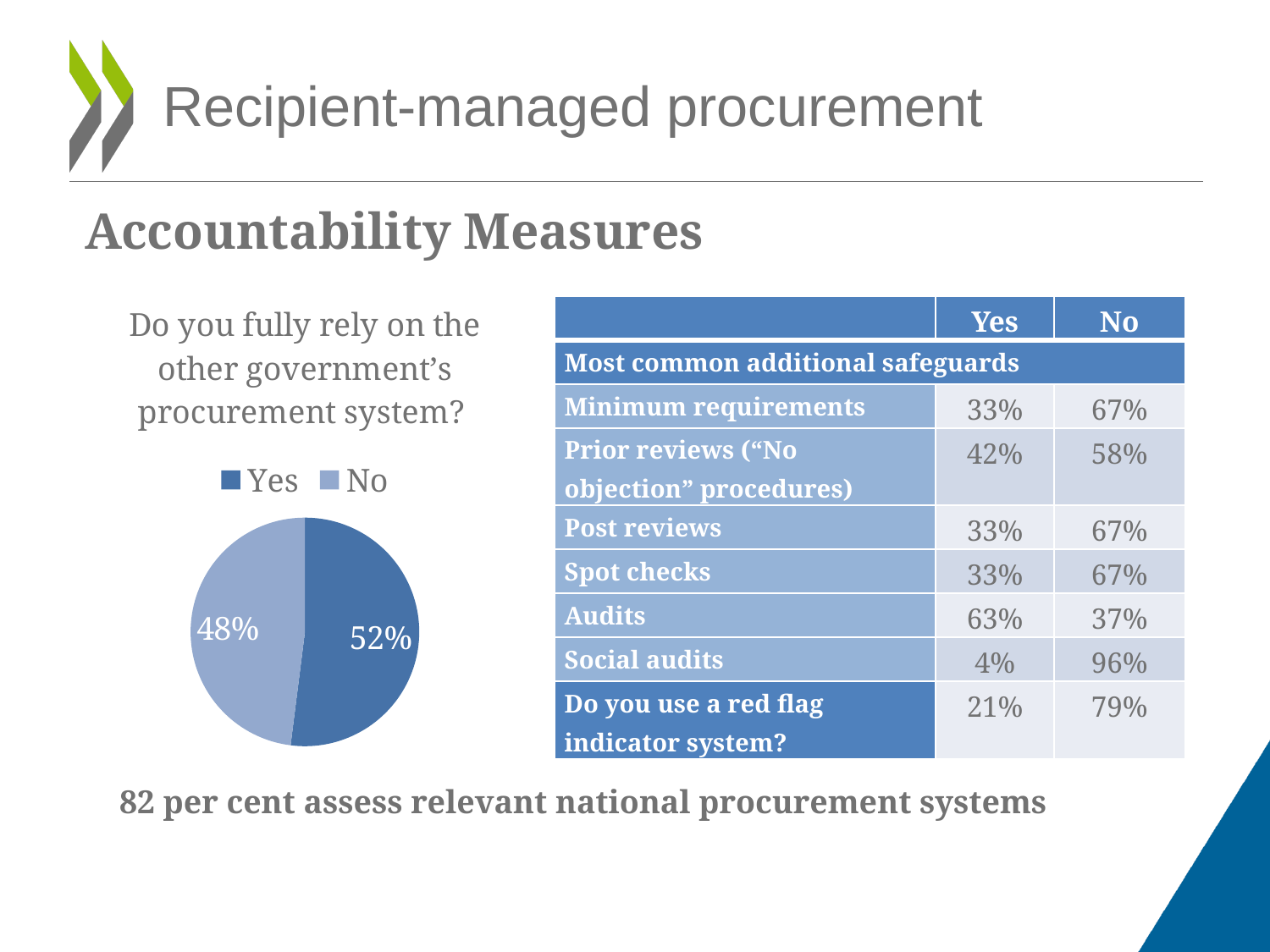
What kind of chart is shown on the slide? Pie chart Which slice of the pie chart is the largest? Yes Which slice of the pie chart is the smallest? No In the pie chart, which is larger, the "Yes" slice or the "No" slice? Yes How many slices does the pie chart have? 2 How many entries does the pie chart's legend list? 2 What share of the pie does the "No" slice represent? 48% What is the difference in percentage points between the "Yes" and "No" slices of the pie chart? 4 Which legend entry of the pie chart is shown in the darker blue colour? Yes What percentage of the pie chart is labelled "Yes"? 52% What percentage of the pie chart is labelled "No"? 48% What question is the pie chart titled with? Do you fully rely on the other government's procurement system?